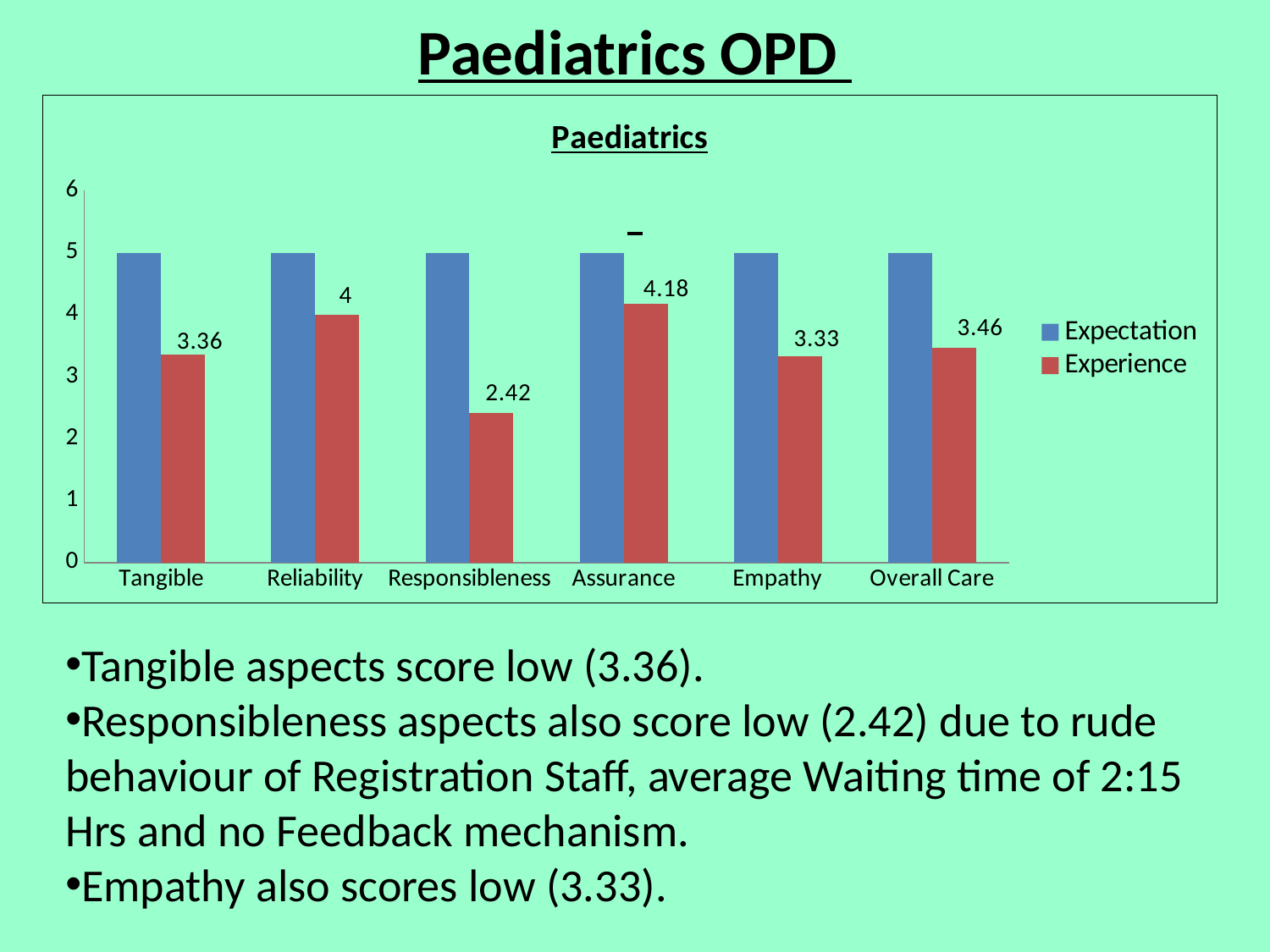
What kind of chart is shown? bar chart What is the Experience value for Overall Care? 3.46 How many series does the legend list? 2 What is the Experience value for Assurance? 4.18 Which has a larger Experience value, Reliability or Empathy? Reliability What is the Experience value for Responsibleness? 2.42 How many categories are shown on the x axis? 6 What is the Experience value for Tangible? 3.36 Which category has the lowest Experience value? Responsibleness Which category has the highest Experience value? Assurance Is the Expectation value for Tangible greater or less than 4? greater What is the difference between the Experience values for Assurance and Responsibleness? 1.76